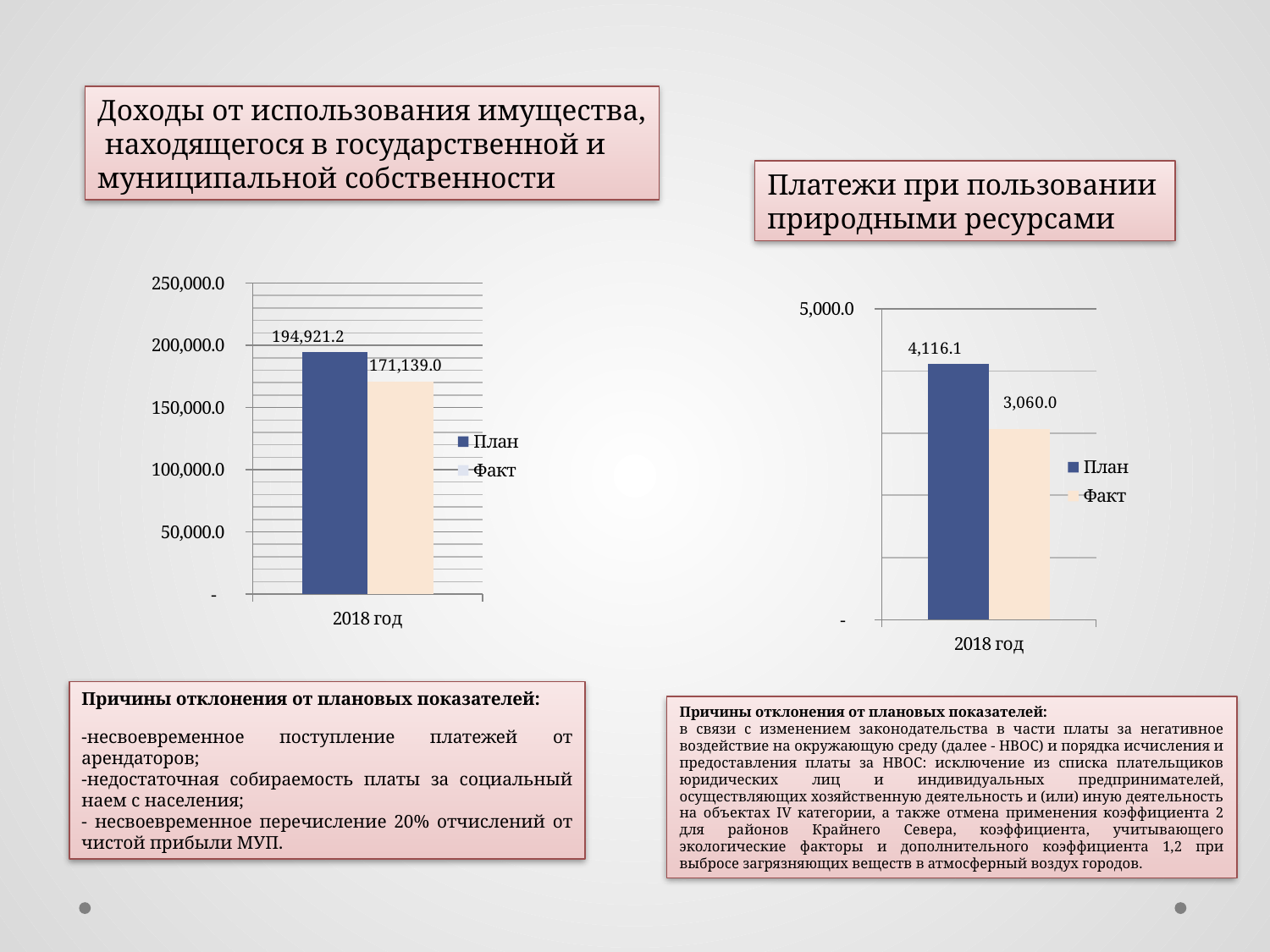
In the left chart (Доходы от использования имущества), what is the value for Факт in 2018 год? 171,139.0 In the left chart, what is the difference between План and Факт? 23,782.2 In the left chart, is the value for Факт greater or less than 150,000.0? greater In the right chart (Платежи при пользовании природными ресурсами), what is the value for Факт? 3,060.0 In the right chart (Платежи при пользовании природными ресурсами), what is the value for План? 4,116.1 In the right chart, which series has the lower value? Факт In the left chart, which is larger, План or Факт? План What is the title of the right chart? Платежи при пользовании природными ресурсами How many series does the legend of the right chart list? 2 What type of chart is the left chart? Bar chart In the right chart, what is the difference between План and Факт? 1,056.1 In the left chart (Доходы от использования имущества), what is the value for План in 2018 год? 194,921.2